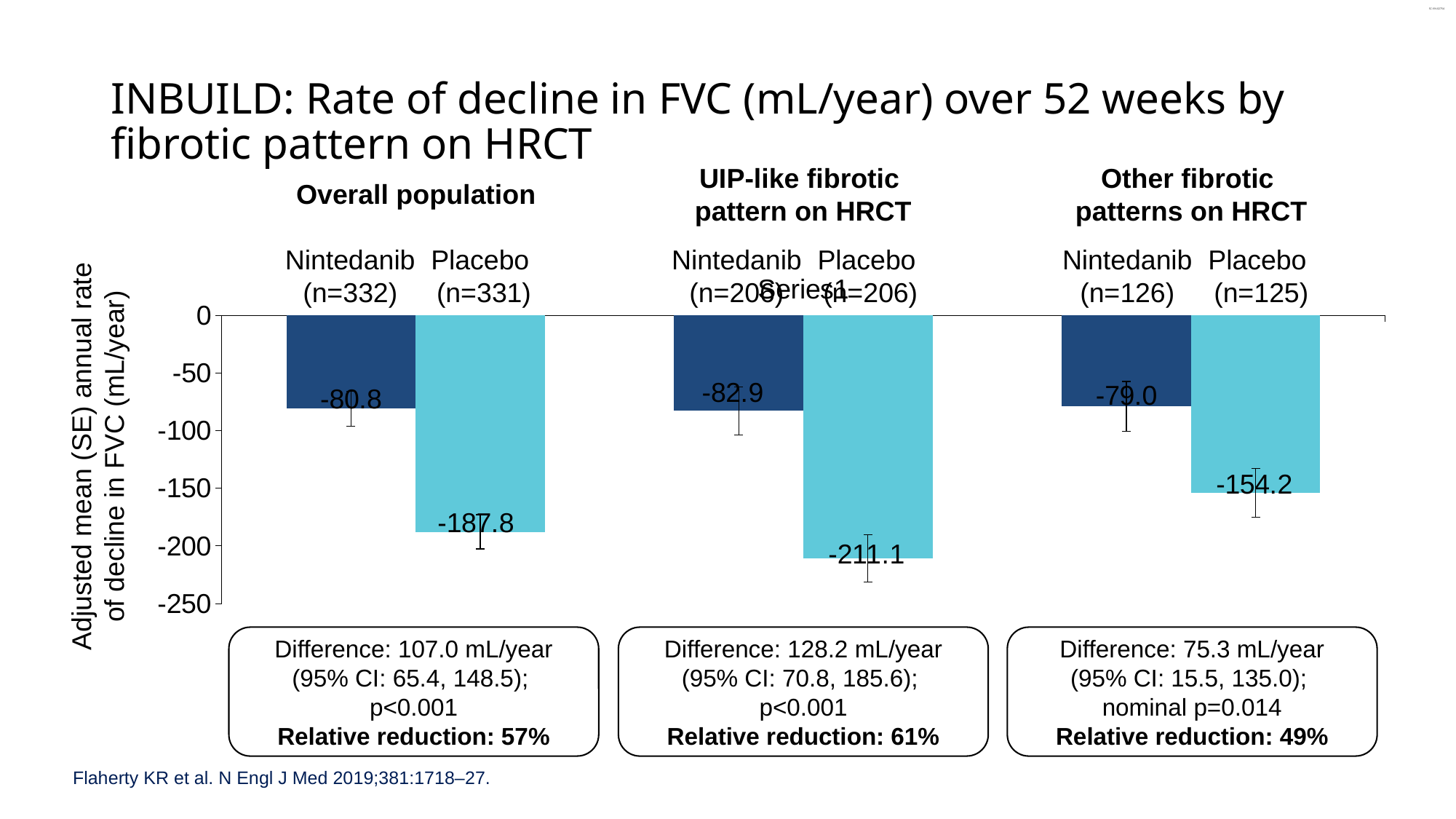
What is the adjusted mean annual rate of decline in FVC for Nintedanib in the overall population? -80.8 Which has a greater decline in FVC: Placebo in the overall population or Placebo in the other fibrotic patterns group? Placebo in the overall population What is the value for Nintedanib in the other fibrotic patterns on HRCT group? -79.0 Which bar shows the smallest decline in FVC (the least negative value)? Nintedanib, other fibrotic patterns on HRCT (-79.0) What is the difference between the Nintedanib and Placebo values in the UIP-like fibrotic pattern group? 128.2 What is the value for Placebo in the other fibrotic patterns on HRCT group? -154.2 What is the value for Placebo in the UIP-like fibrotic pattern on HRCT group? -211.1 Which bar shows the largest decline in FVC (the most negative value)? Placebo, UIP-like fibrotic pattern on HRCT (-211.1) What is the difference between the Nintedanib and Placebo values in the overall population? 107.0 What is the adjusted mean annual rate of decline in FVC for Placebo in the overall population? -187.8 What kind of chart is shown on the slide? Bar chart How many bars are plotted on the chart? 6